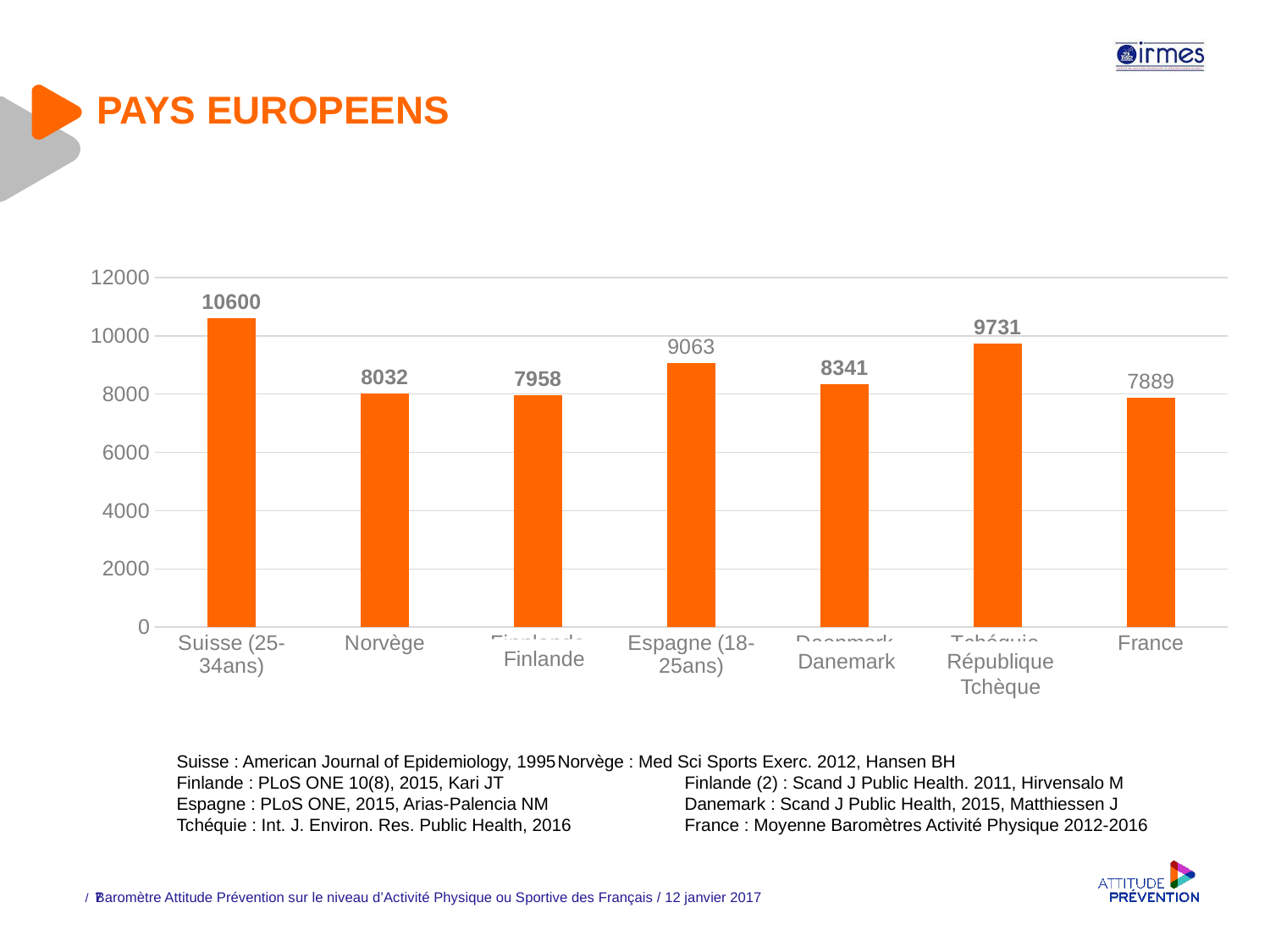
Which is larger, the value for Danemark or the value for Finlande? Danemark What is the value for Norvège? 8032 What is the value for Suisse (25-34ans)? 10600 What is the value for République Tchèque? 9731 Which country has the highest value? Suisse (25-34ans) Which country has the lowest value? France What is the difference between the values for Espagne (18-25ans) and Danemark? 722 Is the value for Espagne (18-25ans) greater or less than 10000? less What is the difference between the values for Suisse (25-34ans) and France? 2711 What kind of chart is shown on the slide? bar chart What is the value for France? 7889 How many countries are shown in the chart? 7